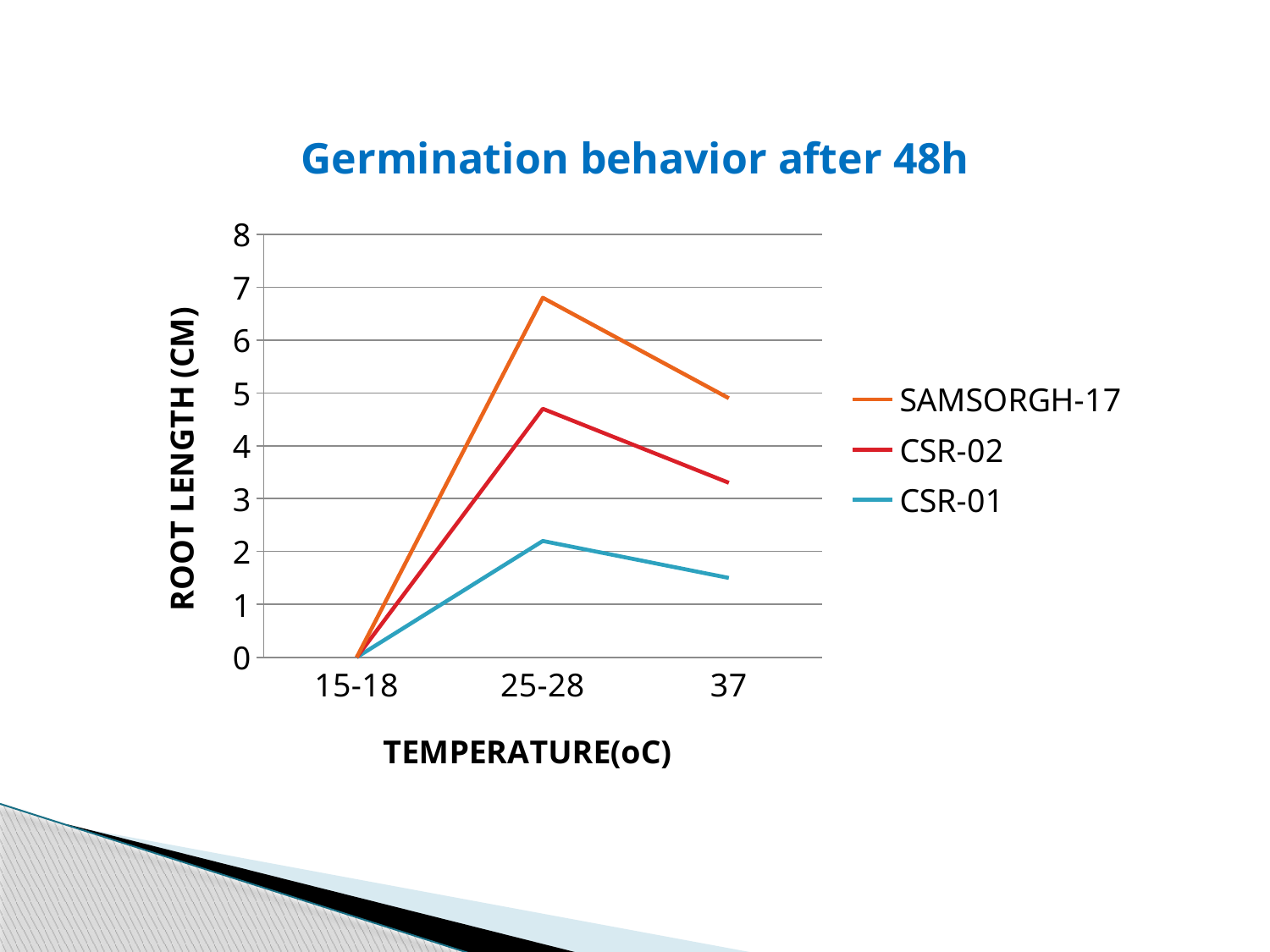
Which series has the lowest root length at 37? CSR-01 Do the root length values for CSR-02 rise or fall from 25-28 to 37? fall Which series has the highest root length at 25-28? SAMSORGH-17 Is the root length for CSR-02 at 37 greater or less than 3? greater How many series does the legend list? 3 What is the title of the chart? Germination behavior after 48h At 37, which series has the larger root length, CSR-02 or CSR-01? CSR-02 What is the root length for SAMSORGH-17 at 15-18? 0 Is the root length for SAMSORGH-17 at 25-28 greater or less than 6? greater What kind of chart is shown on the slide? line chart Is the root length for CSR-01 at 37 greater or less than 2? less How many temperature categories are shown on the x axis? 3